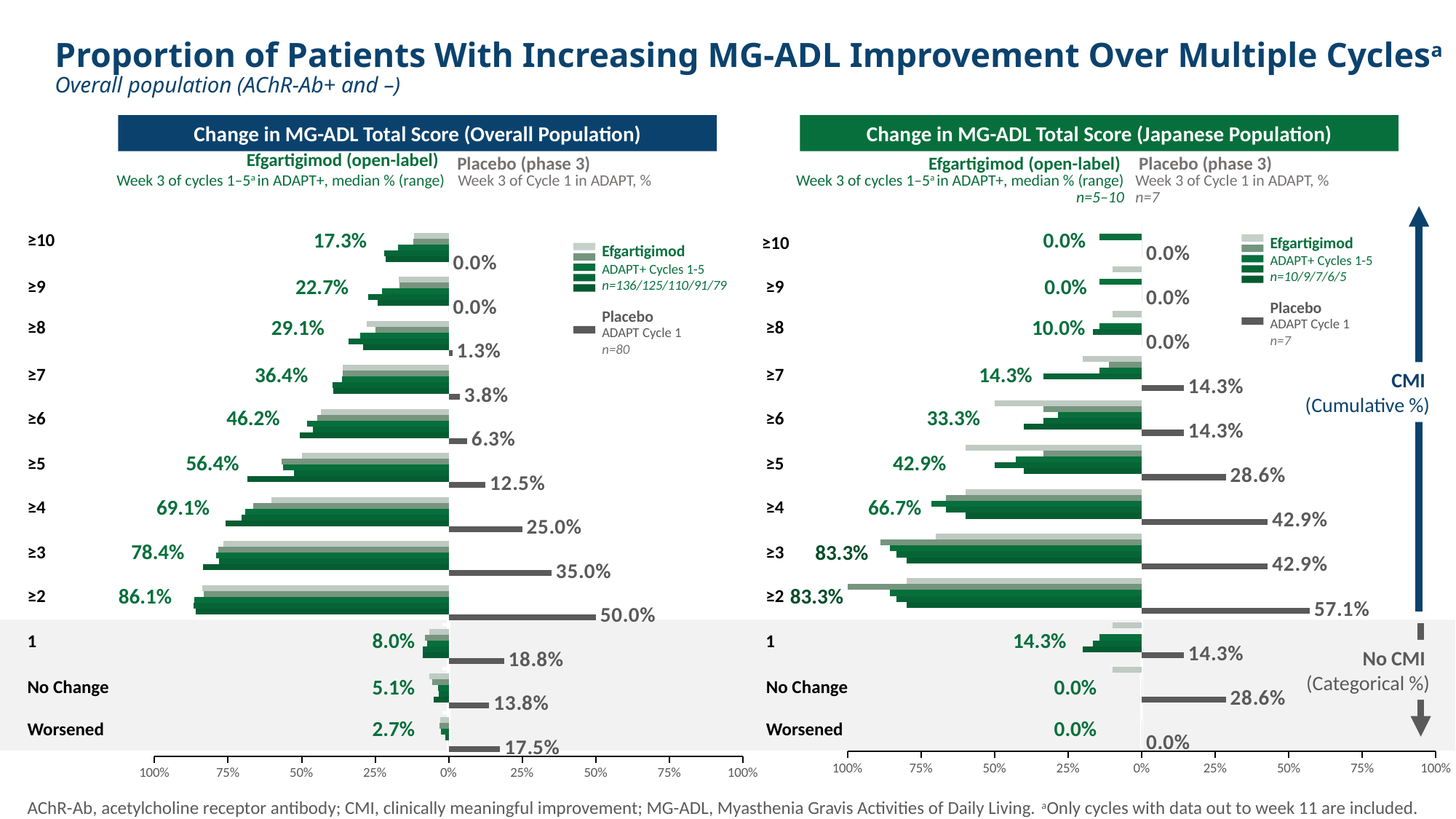
In the Japanese Population chart, what is the difference between the efgartigimod and placebo percentages for a ≥3-point improvement? 40.4% In the Overall Population chart legend, what are the sample sizes listed for the efgartigimod ADAPT+ Cycles 1-5? n=136/125/110/91/79 In the Overall Population chart, what is the efgartigimod median percentage of patients with a ≥2-point MG-ADL improvement? 86.1% In the Japanese Population chart, what is the placebo percentage for a ≥2-point improvement? 57.1% In the Japanese Population chart, what is the efgartigimod median percentage for a ≥4-point improvement? 66.7% In the Overall Population chart, what is the placebo percentage for a ≥3-point improvement? 35.0% What type of chart is used to show the Change in MG-ADL Total Score for the Overall Population? Bar chart In the Overall Population chart, which is larger for the 'Worsened' category: the efgartigimod percentage or the placebo percentage? Placebo In the Japanese Population chart, what is the placebo percentage for 'No Change'? 28.6% In the Overall Population chart, which improvement threshold has the highest placebo percentage? ≥2 How many row categories (improvement thresholds plus 1, No Change and Worsened) are shown in the Overall Population chart? 12 In the Overall Population chart, what is the difference between the efgartigimod and placebo percentages for a ≥2-point improvement? 36.1%